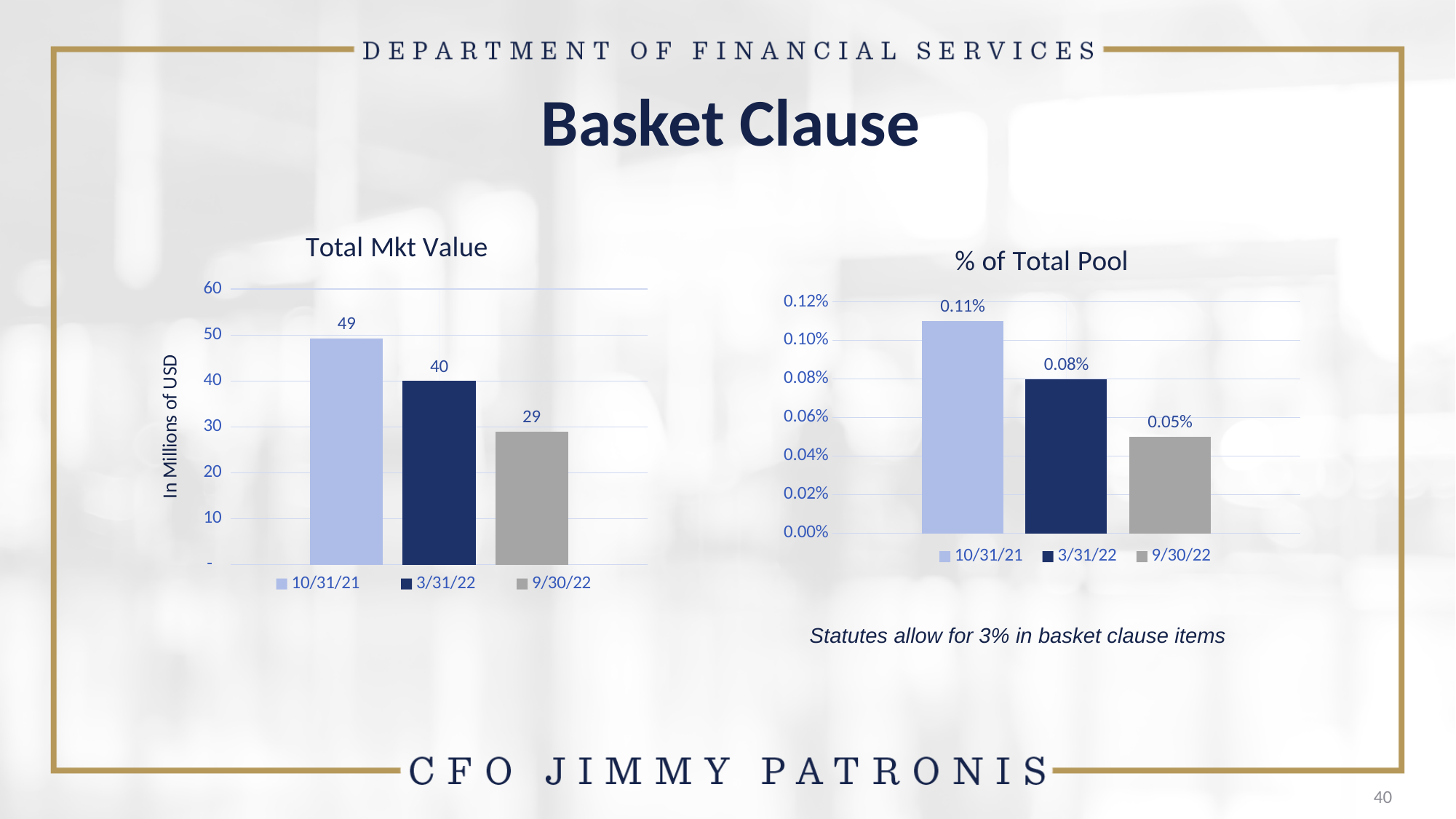
In the 'Total Mkt Value' chart, which date has the highest value? 10/31/21 In the '% of Total Pool' chart, which date has the lowest value? 9/30/22 In the '% of Total Pool' chart, what is the difference between the values for 10/31/21 and 9/30/22? 0.06% In the 'Total Mkt Value' chart, which is larger: the value for 3/31/22 or the value for 9/30/22? 3/31/22 What kind of chart is the 'Total Mkt Value' chart? bar chart In the 'Total Mkt Value' chart, what is the value for 9/30/22? 29 In the 'Total Mkt Value' chart, what is the value for 10/31/21? 49 In the '% of Total Pool' chart, do the values rise or fall from 10/31/21 to 9/30/22? fall In the 'Total Mkt Value' chart, what is the difference between the values for 10/31/21 and 3/31/22? 9 In the '% of Total Pool' chart, what is the value for 9/30/22? 0.05% How many series does the legend of the '% of Total Pool' chart list? 3 In the '% of Total Pool' chart, what is the value for 3/31/22? 0.08%